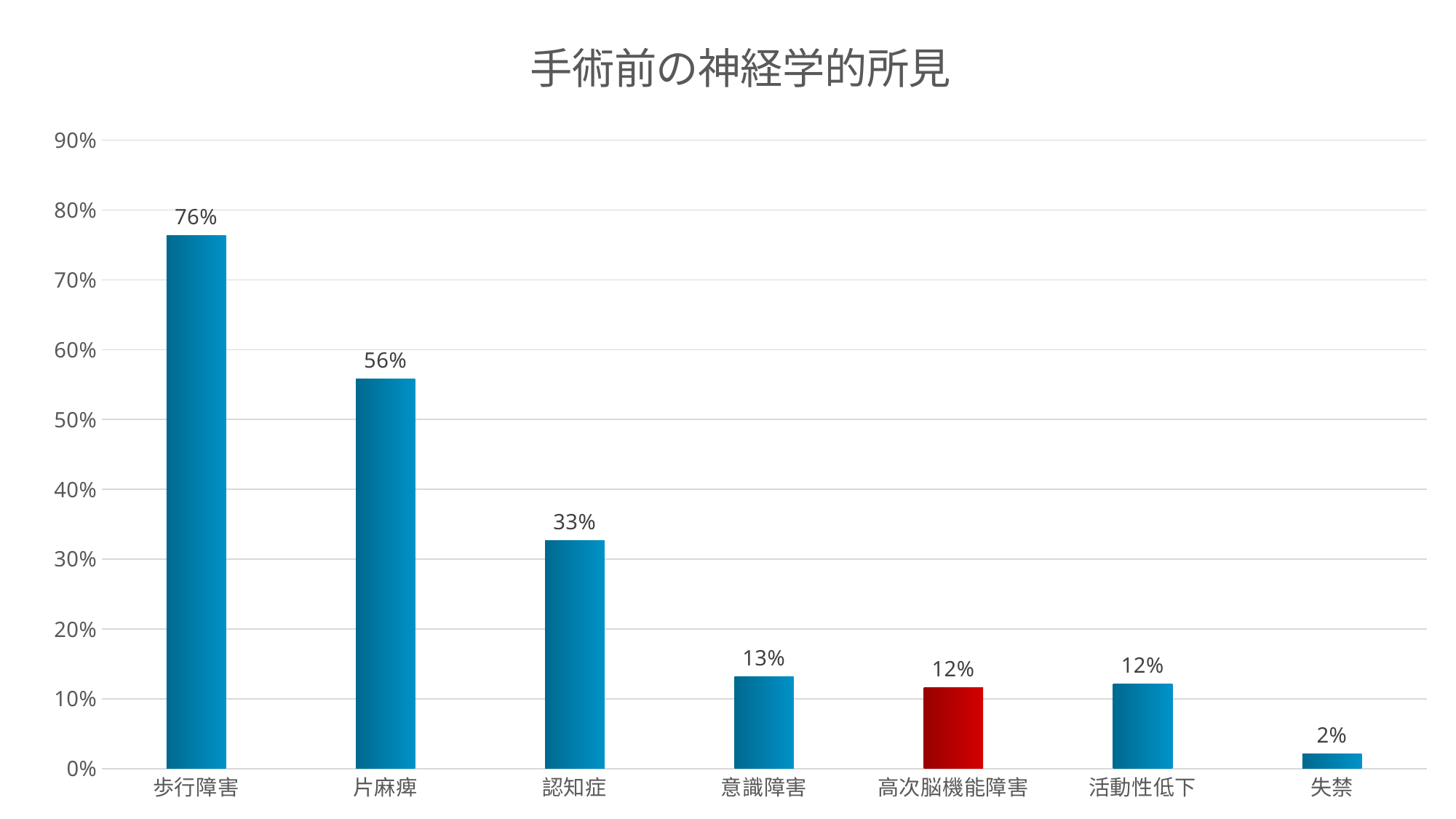
Which category has the lowest value? 失禁 What is the difference between the values for 認知症 and 意識障害? 20% How many categories are shown in the chart? 7 Is the value for 片麻痺 greater or less than 50%? greater What kind of chart is shown on the slide? bar chart Which is larger, the value for 片麻痺 or the value for 認知症? 片麻痺 Which category has the highest value? 歩行障害 What is the value for 高次脳機能障害? 12% Which category's bar is coloured red instead of blue? 高次脳機能障害 What is the value for 認知症? 33% What is the difference between the values for 歩行障害 and 片麻痺? 20% What is the value for 歩行障害? 76%